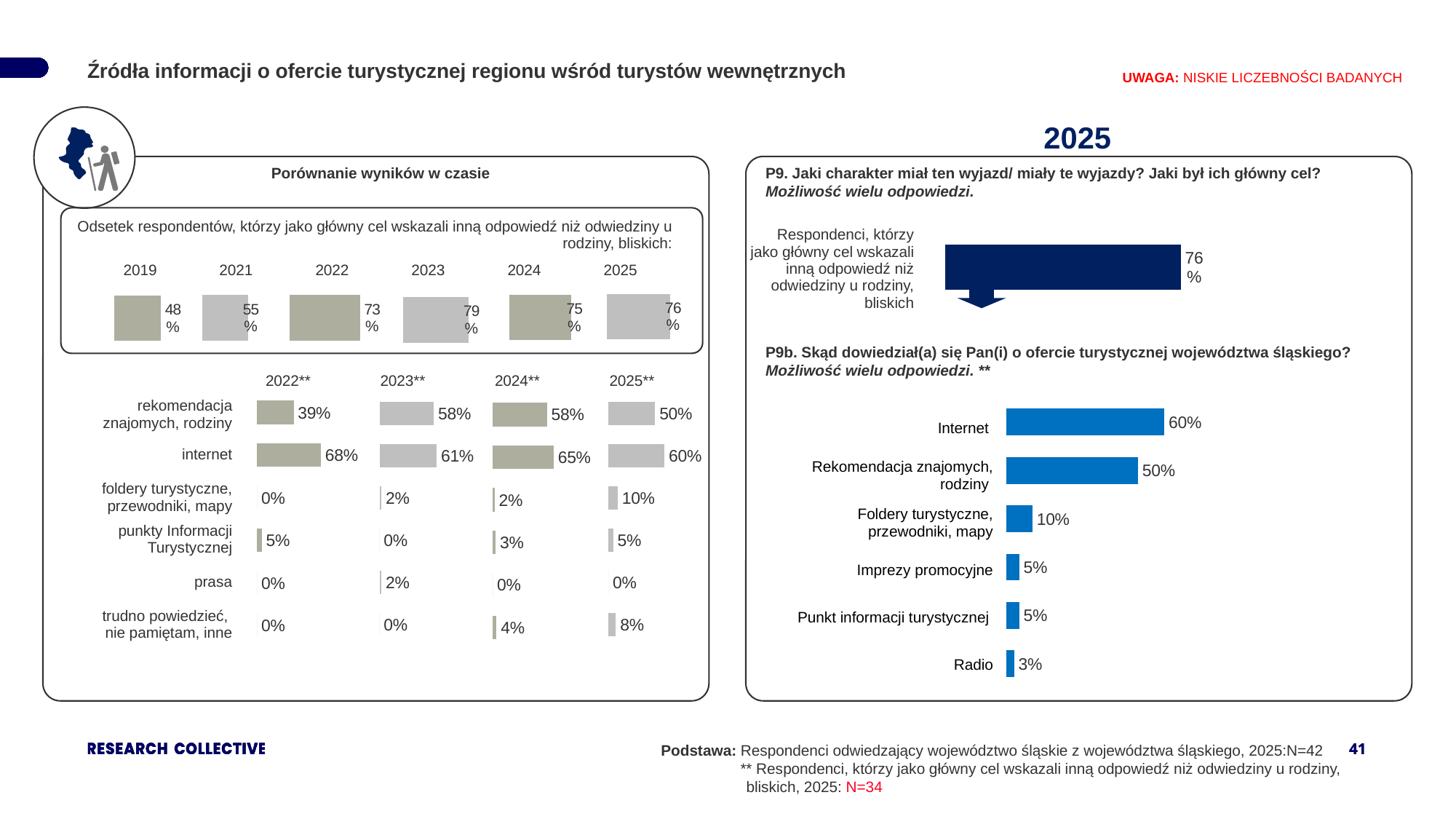
In the bottom-left comparison chart, which is larger for 2022**: rekomendacja znajomych, rodziny or internet? internet What kind of chart is the P9b chart on the right? Bar chart In the P9b chart on the right, how many categories are shown? 6 In the top-left chart showing years 2019 to 2025, what is the difference between 2025 and 2019? 28% In the top-left chart (Odsetek respondentów, którzy jako główny cel wskazali inną odpowiedź niż odwiedziny u rodziny, bliskich), what is the value for 2019? 48% In the P9b chart on the right, which source has the lowest value? Radio In the top-left chart showing years 2019 to 2025, which year has the highest value? 2023 In the bottom-left comparison chart (Porównanie wyników w czasie), what is the value for internet in 2024**? 65% In the P9b chart on the right (Skąd dowiedział(a) się Pan(i) o ofercie turystycznej województwa śląskiego?), what is the value for Internet? 60% In the P9b chart on the right, which source has the highest value? Internet In the P9b chart on the right, what is the value for Foldery turystyczne, przewodniki, mapy? 10% In the P9b chart on the right, what is the difference between Internet and Rekomendacja znajomych, rodziny? 10%